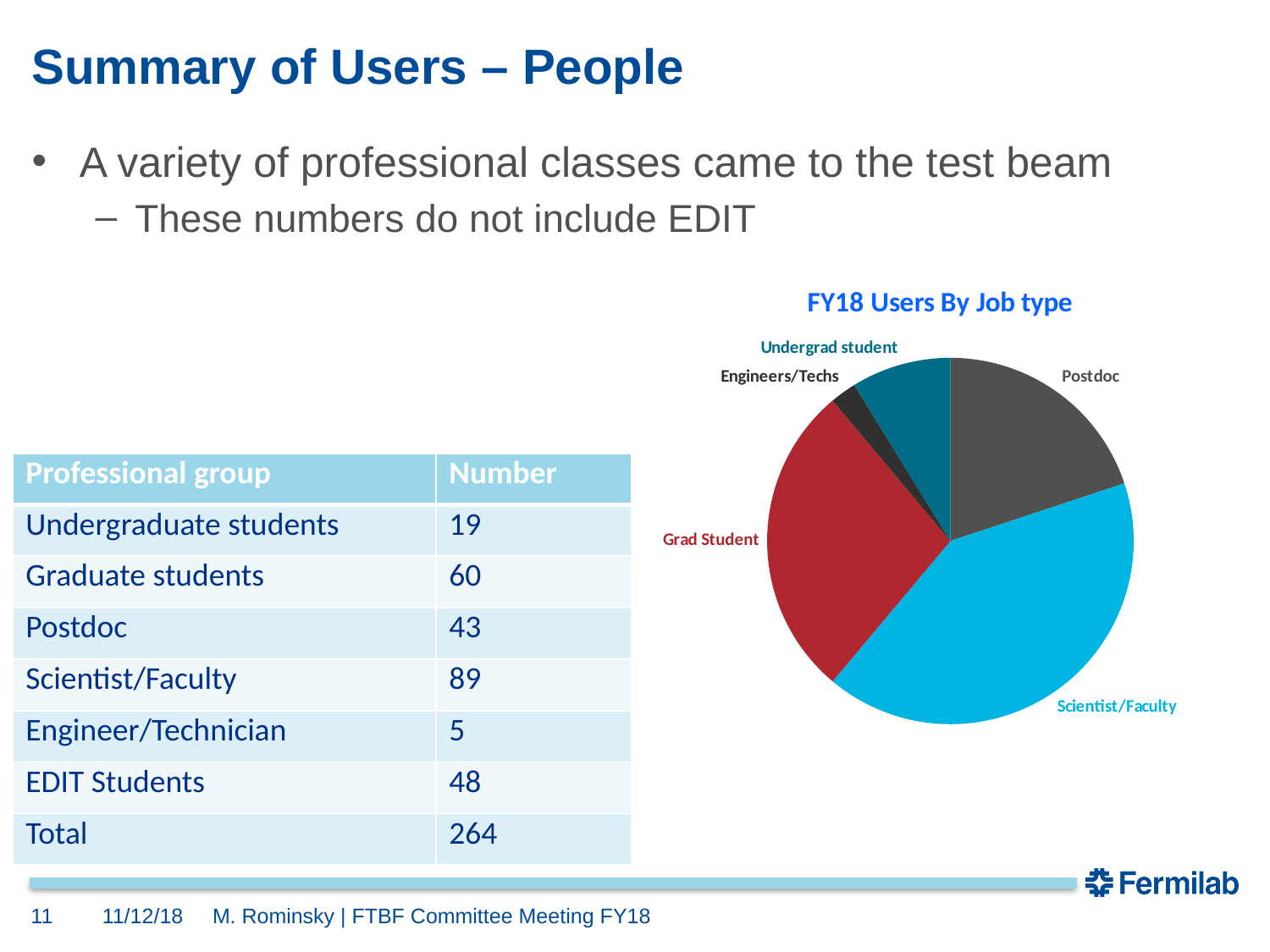
Which job type has the largest slice in the pie chart? Scientist/Faculty Which job type has the smallest slice in the pie chart? Engineers/Techs What colour is the Grad Student slice in the pie chart? red In the pie chart, which slice is larger: Scientist/Faculty or Grad Student? Scientist/Faculty In the pie chart, which slice is larger: Postdoc or Undergrad student? Postdoc What kind of chart is shown on the slide? pie chart How many slices does the pie chart have? 5 What is the title of the pie chart? FY18 Users By Job type In the pie chart, which slice is larger: Undergrad student or Engineers/Techs? Undergrad student